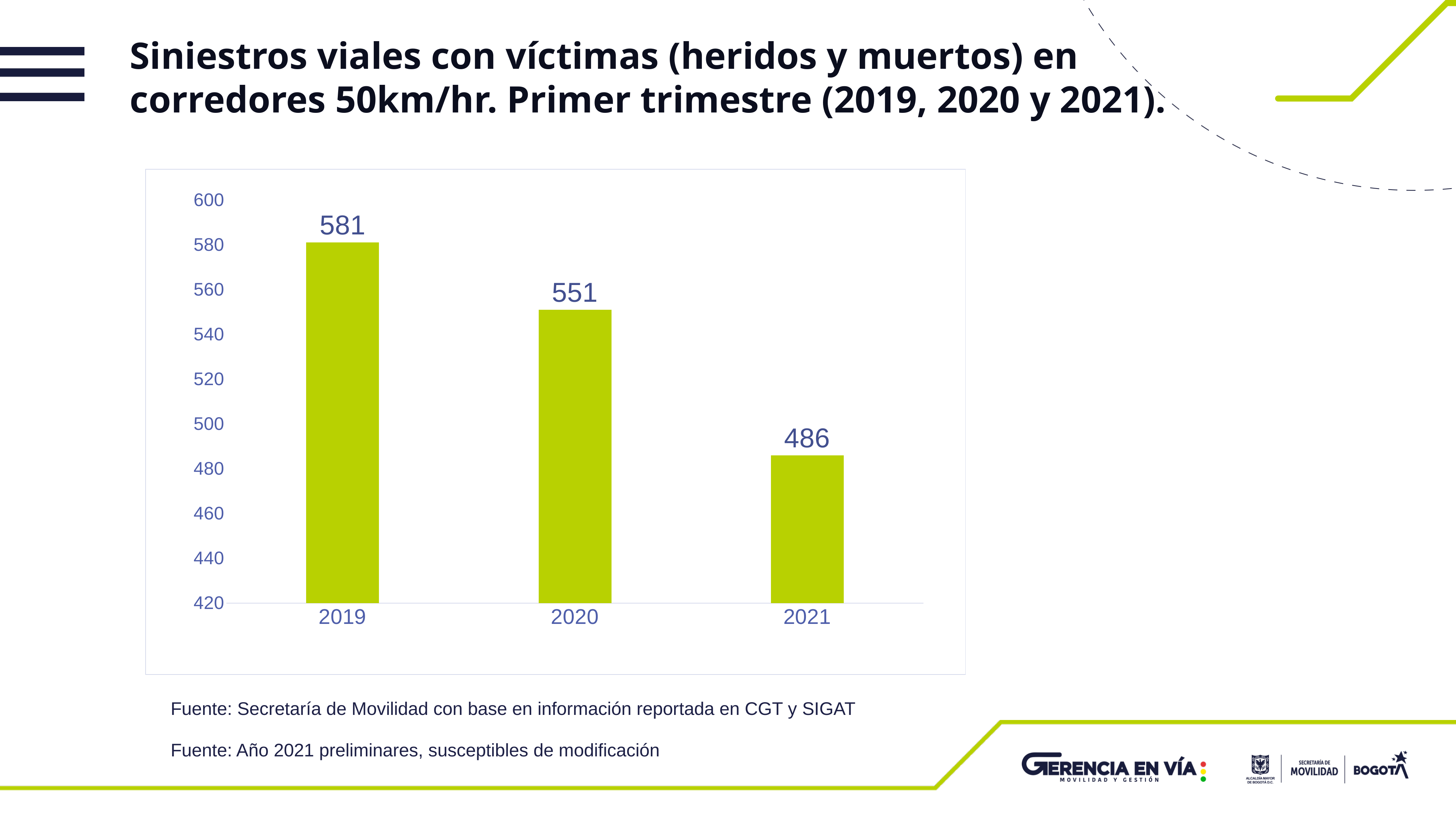
What kind of chart is shown on the slide? bar chart What is the value for 2020? 551 What is the difference between the values for 2019 and 2020? 30 Do the values rise or fall from 2019 to 2021? fall What is the difference between the values for 2019 and 2021? 95 How many years are shown on the x axis? 3 Which is larger, the value for 2020 or the value for 2021? 2020 Is the value for 2021 greater or less than 500? less What is the value for 2019? 581 Which year has the highest value? 2019 Which year has the lowest value? 2021 What is the value for 2021? 486